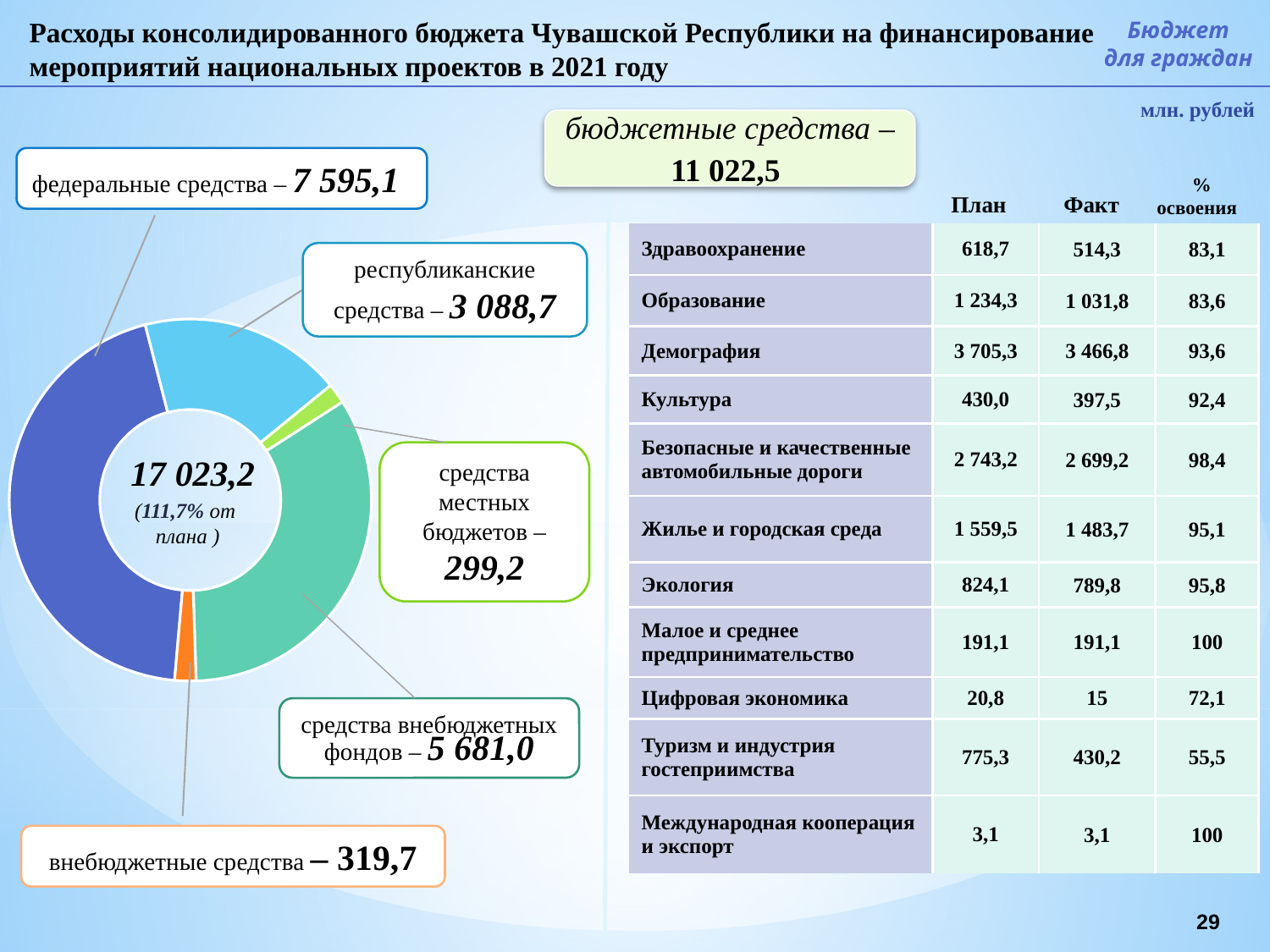
In the donut chart, what is the value for федеральные средства? 7 595,1 What total value is shown in the centre of the donut chart? 17 023,2 In the donut chart, what is the difference between федеральные средства and республиканские средства? 4 506,4 In the donut chart, what is the value for средства местных бюджетов? 299,2 Which source of funds has the smallest value in the donut chart? средства местных бюджетов In the donut chart, what is the value for средства внебюджетных фондов? 5 681,0 In the donut chart, what is the value for республиканские средства? 3 088,7 What type of chart is shown on the left of the slide? Donut (pie) chart Which source of funds has the largest value in the donut chart? федеральные средства In the donut chart, which is larger: республиканские средства or средства внебюджетных фондов? средства внебюджетных фондов What percentage of the plan is shown in the centre of the donut chart? 111,7% How many segments does the donut chart have? 5